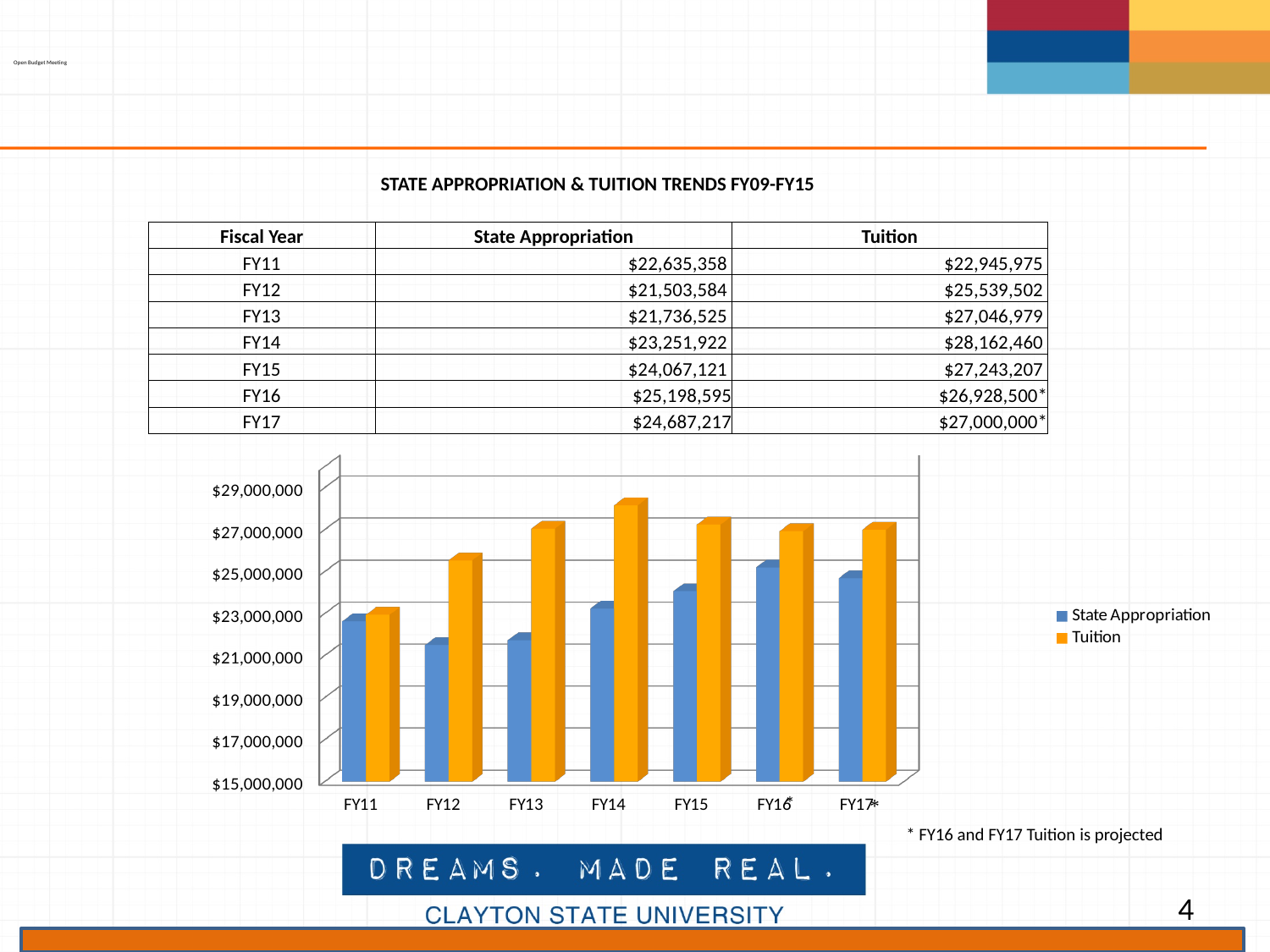
How many series does the chart legend list? 2 How many fiscal years are plotted on the x axis of the chart? 7 What is the State Appropriation value for FY14? $23,251,922 What is the difference between Tuition and State Appropriation in FY15? $3,176,086 What kind of chart is shown on the slide? Bar chart Is the Tuition value for FY14 greater or less than $27,000,000? greater Does Tuition rise or fall from FY11 to FY14? Rise In FY12, which is larger: State Appropriation or Tuition? Tuition Which fiscal year has the highest Tuition value? FY14 Which fiscal year has the lowest State Appropriation value? FY12 What colour represents Tuition in the chart? Orange What is the Tuition value for FY13? $27,046,979